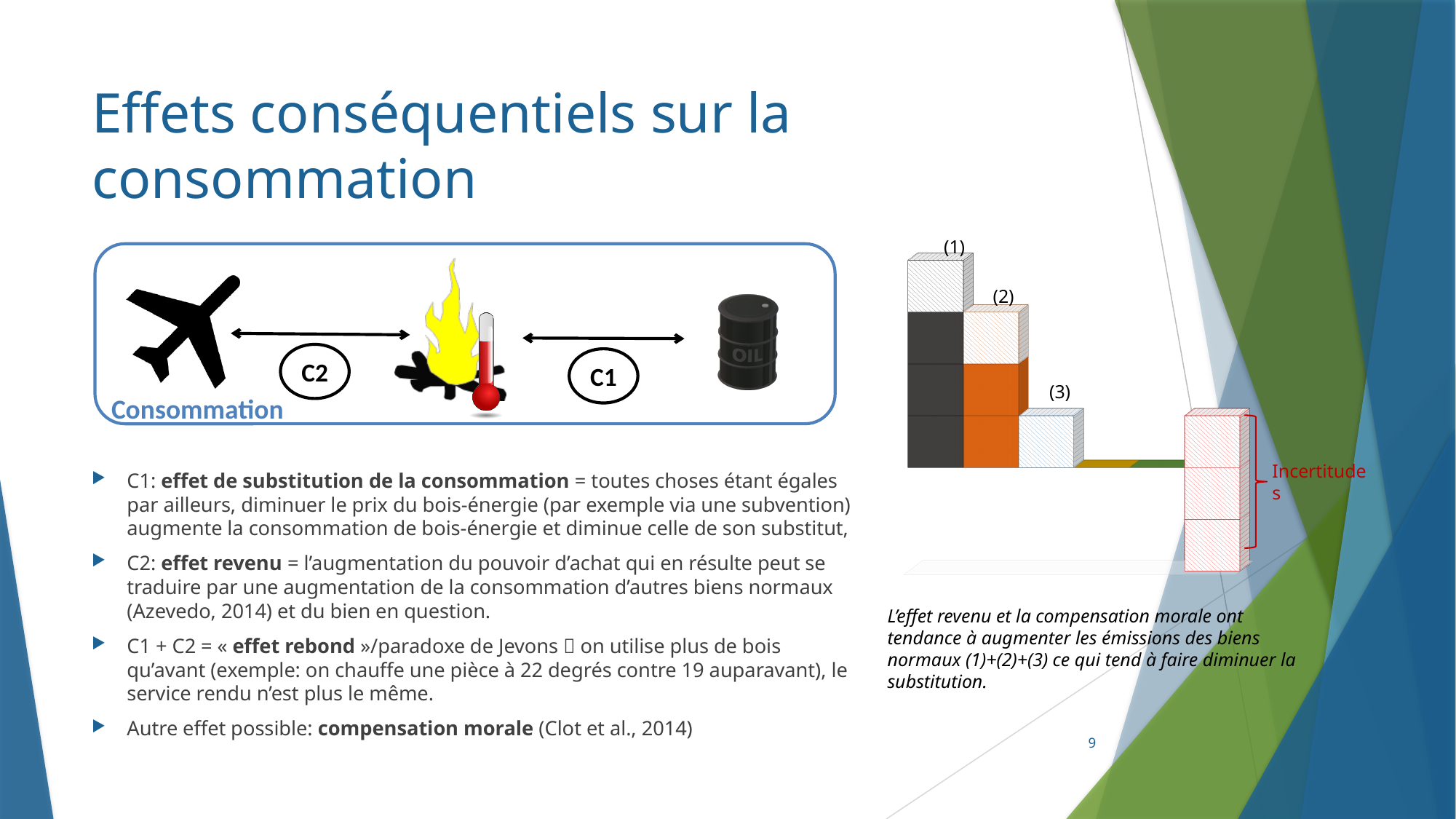
In the chart on the right, which of the numbered bars is the tallest? (1) How many numbered bars, (1), (2) and (3), are shown in the chart on the right? 3 In the chart on the right, what colour is the lower solid segment of bar (2)? orange In the chart on the right, do the bar heights rise or fall going from (1) to (3)? fall In the chart on the right, which bar is taller, (2) or (3)? (2) What kind of chart is shown on the right side of the slide? bar chart In the chart on the right, which of the numbered bars is the shortest? (3) In the chart on the right, which bar is taller, (1) or (2)? (1) What label is written in red next to the red hatched bar in the chart on the right? Incertitudes